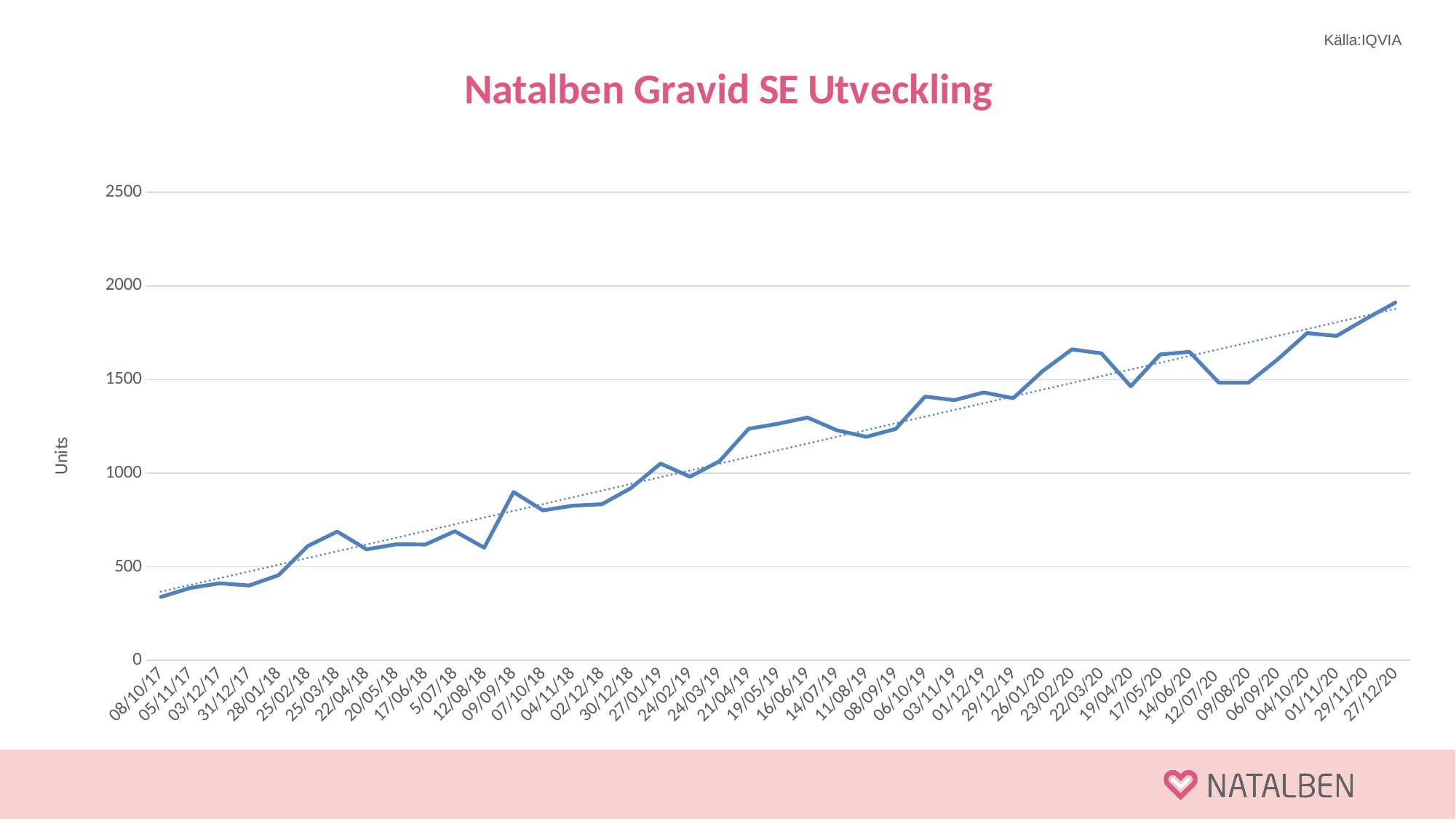
Is the value for 23/02/20 greater or less than 1500? greater Which date has the lowest value on the chart? 08/10/17 How many data points are plotted along the x axis? 43 What is the title of the chart? Natalben Gravid SE Utveckling Do the values generally rise or fall from 08/10/17 to 27/12/20? rise Which date has the highest value on the chart? 27/12/20 Is the value for 08/10/17 greater or less than 500? less Is the value for 21/04/19 greater or less than 1000? greater What kind of chart is shown on the slide? line chart Which is larger, the value for 09/09/18 or the value for 12/08/18? 09/09/18 What is the label on the vertical axis of the chart? Units